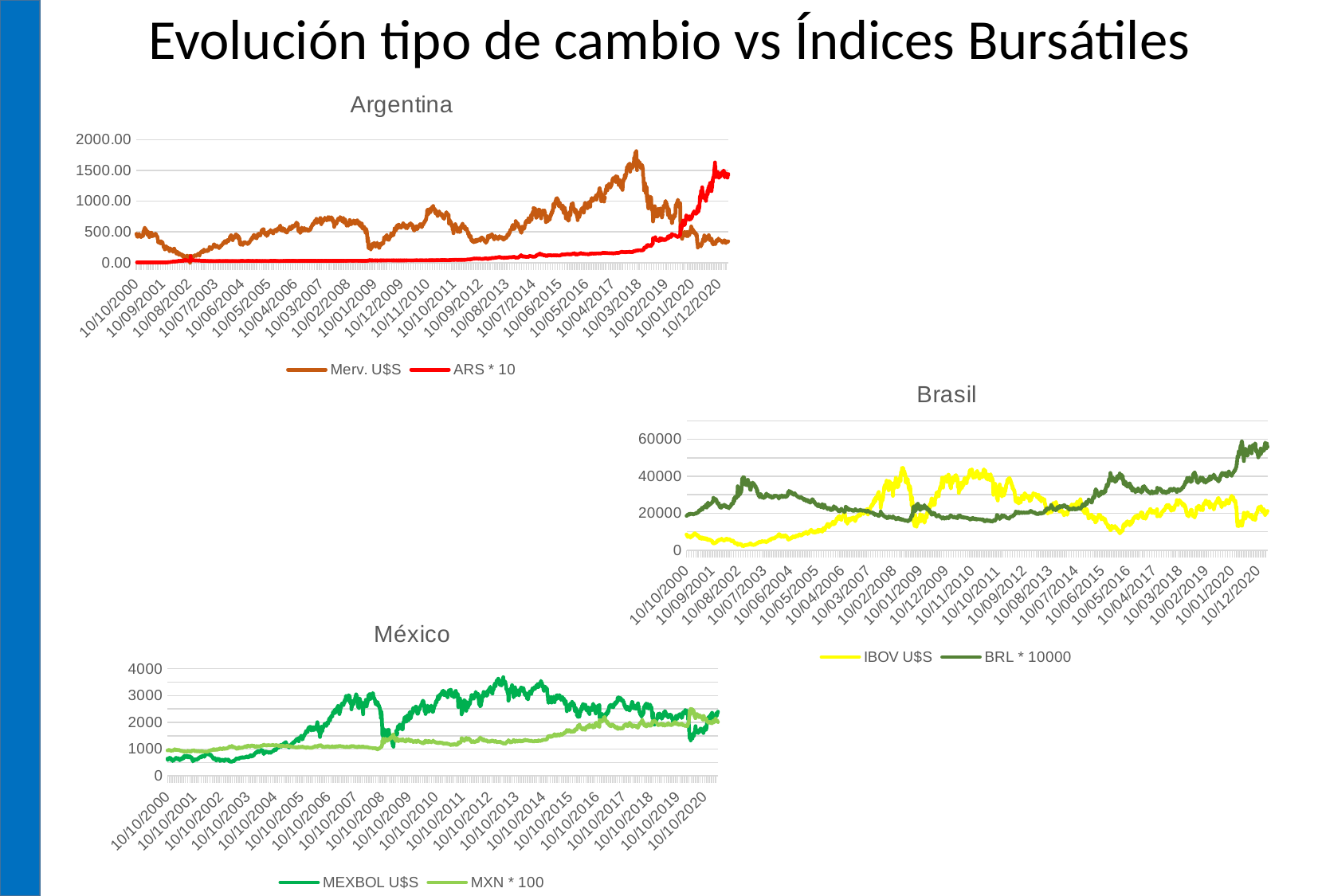
In the Brasil chart, is the value of IBOV U$S at 10/10/2000 greater or less than 20000? less What kind of chart is the Argentina chart? line chart In the Brasil chart, at 10/12/2020, which series is higher, IBOV U$S or BRL * 10000? BRL * 10000 In the Argentina chart, which series is drawn in red? ARS * 10 In the Brasil chart, is the value of BRL * 10000 at 10/12/2020 greater or less than 40000? greater In the Argentina chart, is the highest value reached by Merv. U$S greater or less than 1500.00? greater What are the two series named in the legend of the México chart? MEXBOL U$S and MXN * 100 In the Argentina chart, at the end of the period (10/12/2020), which series has the higher value, Merv. U$S or ARS * 10? ARS * 10 In the México chart, does the MXN * 100 series generally rise or fall from 10/10/2000 to 10/10/2020? rise How many series does the legend of the Brasil chart list? 2